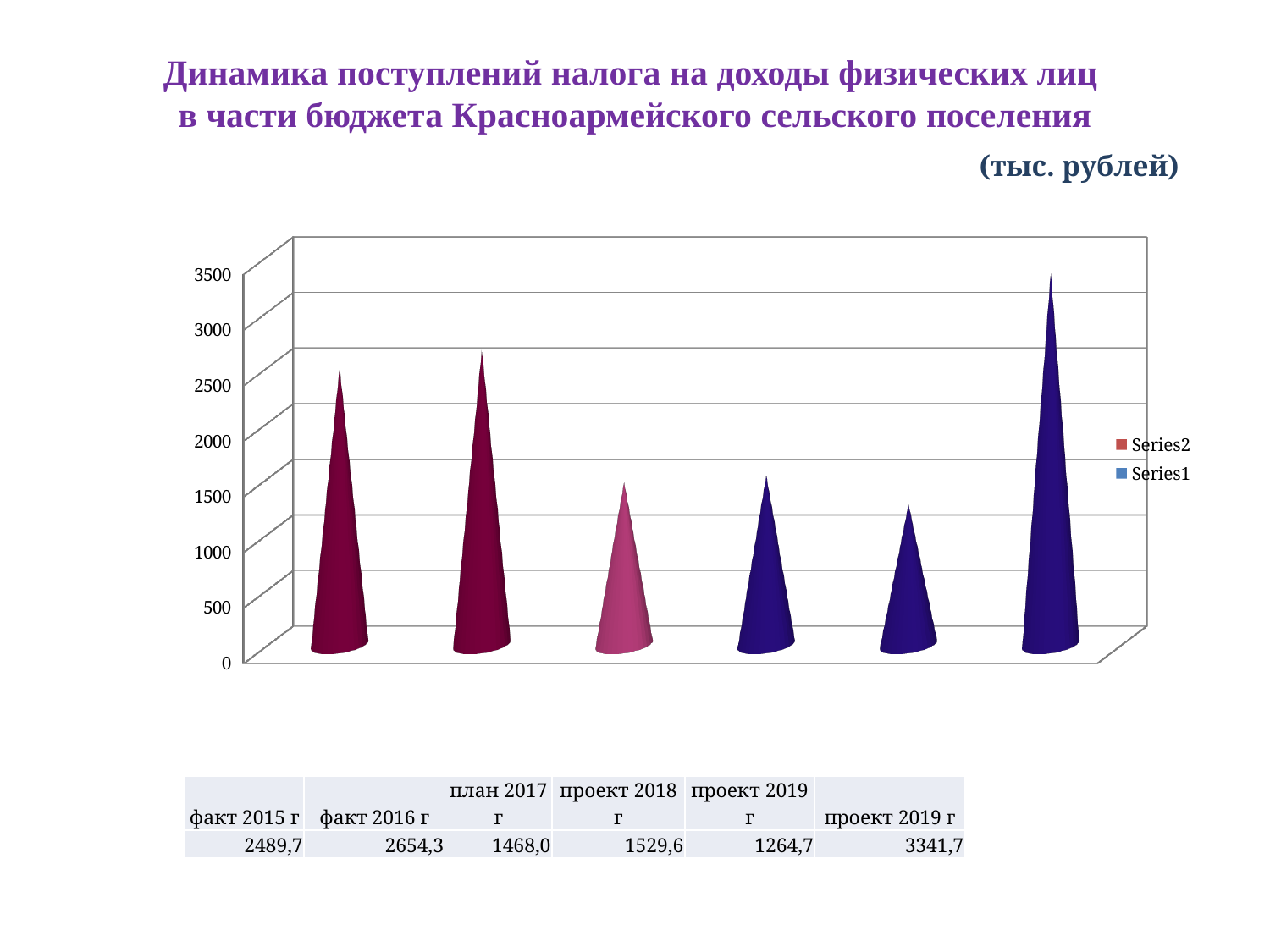
What is the difference between the values for факт 2016 г and факт 2015 г? 164,6 What unit is stated for the values in the chart? тыс. рублей What is the lowest value shown in the chart? 1264,7 What is the value for проект 2018 г? 1529,6 What is the value for план 2017 г? 1468,0 How many series does the legend list? 2 Is the value for факт 2015 г greater or less than 2000? greater How many categories are plotted in the chart? 6 What is the value for факт 2015 г? 2489,7 Which is larger, the value for факт 2016 г or the value for план 2017 г? факт 2016 г What is the highest value shown in the chart? 3341,7 What is the value for факт 2016 г? 2654,3